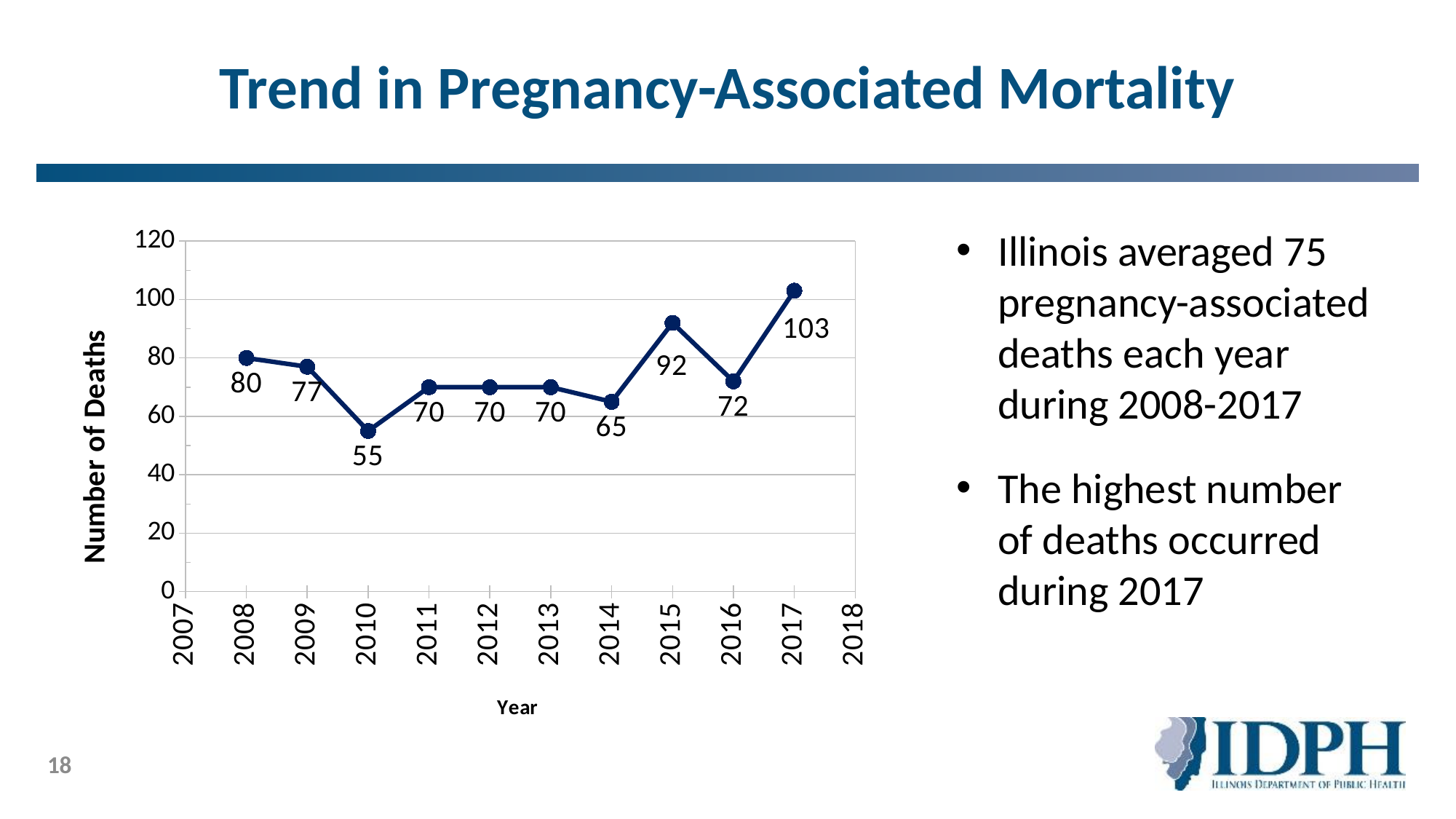
Did the number of deaths rise or fall from 2015 to 2016? fall What is the difference in the number of deaths between 2015 and 2014? 27 What kind of chart is shown on the slide? line chart What was the number of deaths in 2008? 80 Which year had the highest number of deaths? 2017 How many years have data points plotted on the chart? 10 Which year had more deaths, 2009 or 2016? 2009 What is the label of the vertical axis? Number of Deaths What was the number of deaths in 2015? 92 What was the number of deaths in 2010? 55 Which year had the lowest number of deaths? 2010 What is the difference in the number of deaths between 2017 and 2016? 31